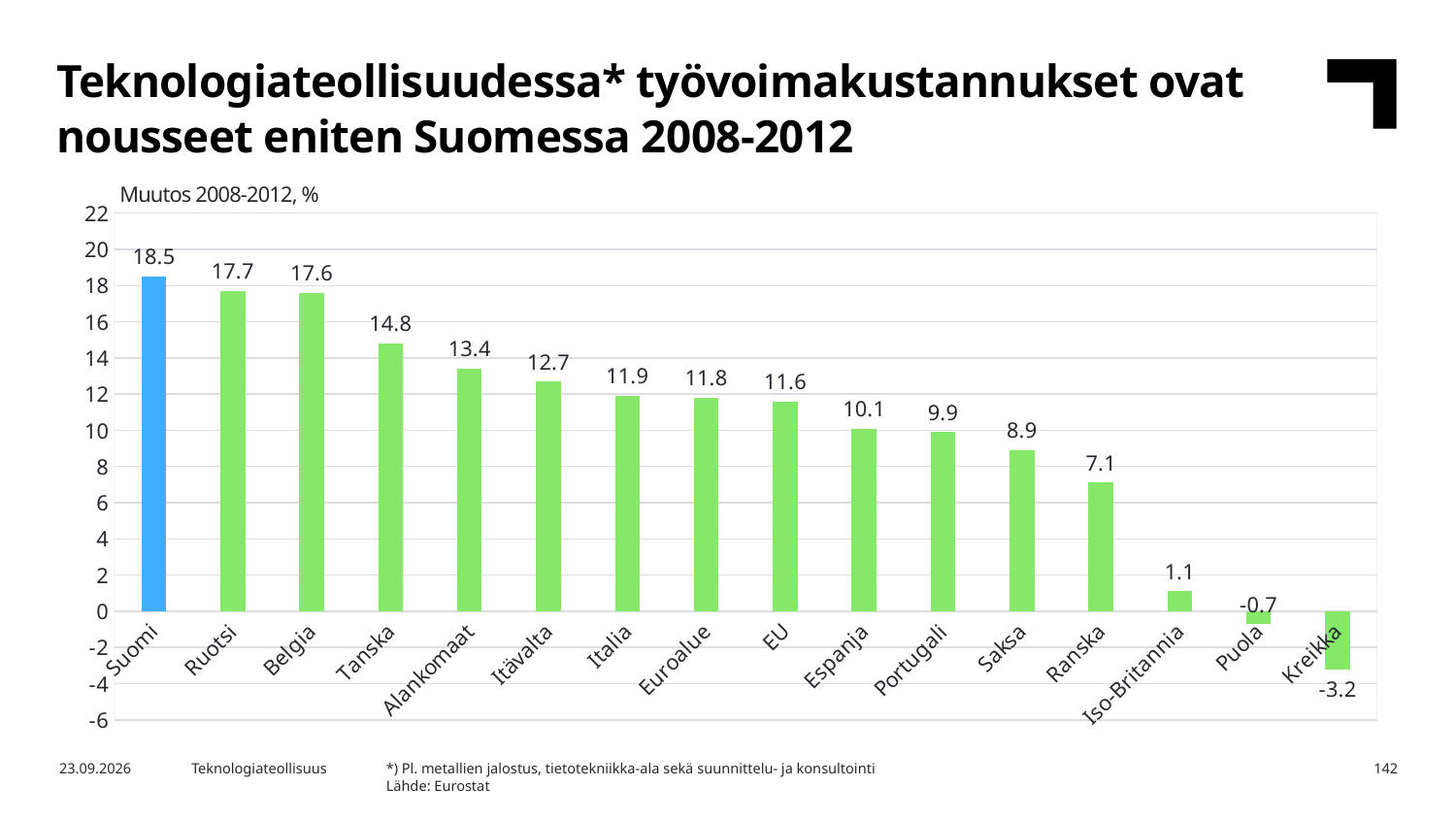
What is the value for Alankomaat? 13.4 What is the value for Suomi? 18.5 What is the difference between the values for Tanska and Saksa? 5.9 Do the values rise or fall from left to right along the x axis? Fall What kind of chart is shown on the slide? Bar chart Which country has the highest value? Suomi What is the difference between the values for Suomi and Ruotsi? 0.8 Which is larger, the value for Espanja or the value for Ranska? Espanja Which bar is coloured differently from the others? Suomi How many categories are shown on the x axis? 16 What is the value for Kreikka? -3.2 Which country has the lowest value? Kreikka